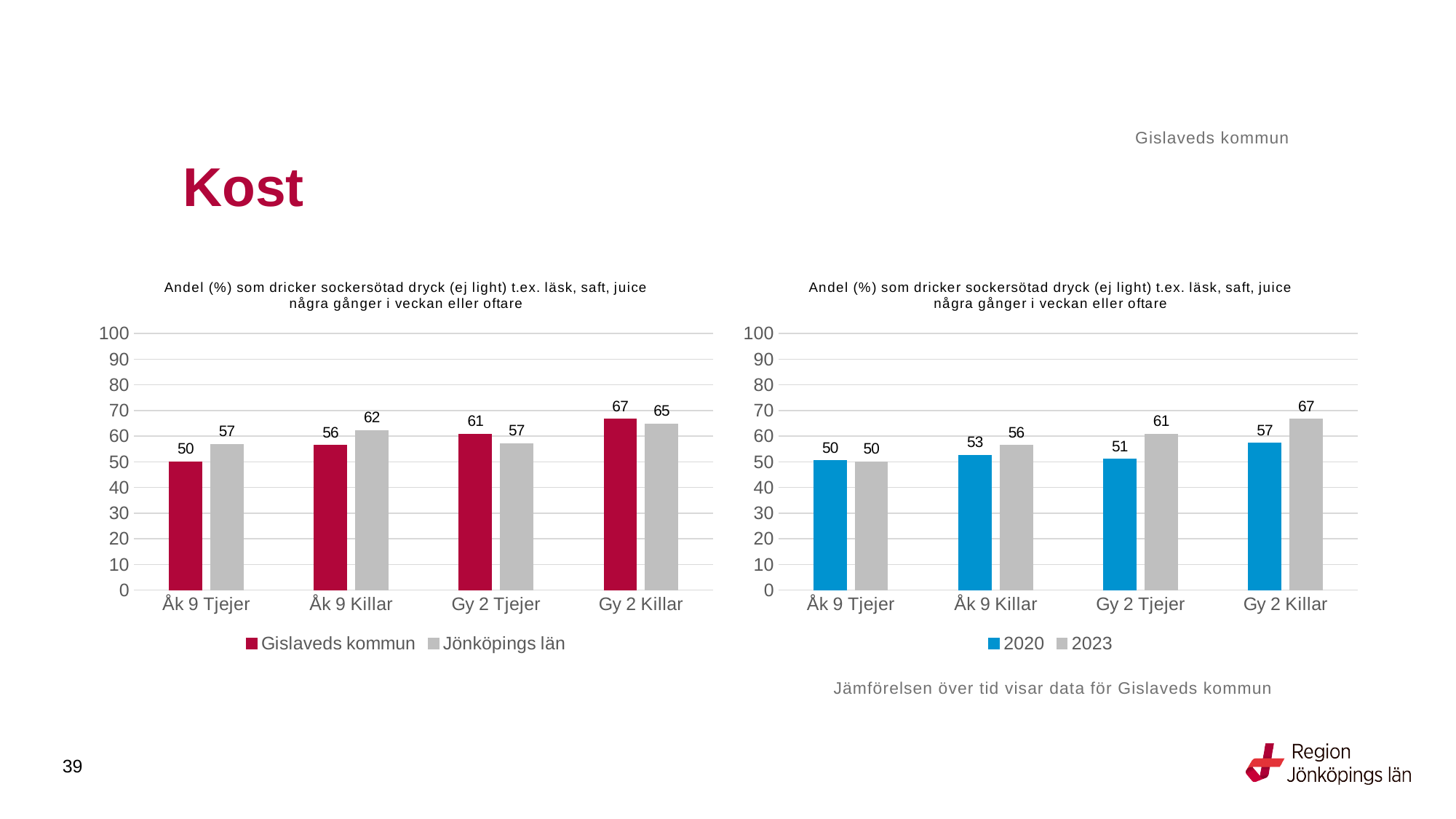
In the right chart, how many series does the legend list? 2 In the right chart, what is the value for 2020 for Gy 2 Killar? 57 What kind of chart is the right chart? Bar chart In the left chart, which category has the highest value for Gislaveds kommun? Gy 2 Killar In the left chart, what is the value for Gislaveds kommun for Åk 9 Tjejer? 50 In the left chart, what is the difference between Jönköpings län and Gislaveds kommun for Åk 9 Tjejer? 7 How many categories are shown on the x axis of the left chart? 4 In the left chart, what is the value for Jönköpings län for Åk 9 Killar? 62 In the right chart, which category has the lowest value for 2023? Åk 9 Tjejer In the right chart, what is the value for 2023 for Gy 2 Tjejer? 61 In the left chart, which is larger for Gy 2 Tjejer: Gislaveds kommun or Jönköpings län? Gislaveds kommun In the right chart, what is the difference between 2023 and 2020 for Gy 2 Killar? 10